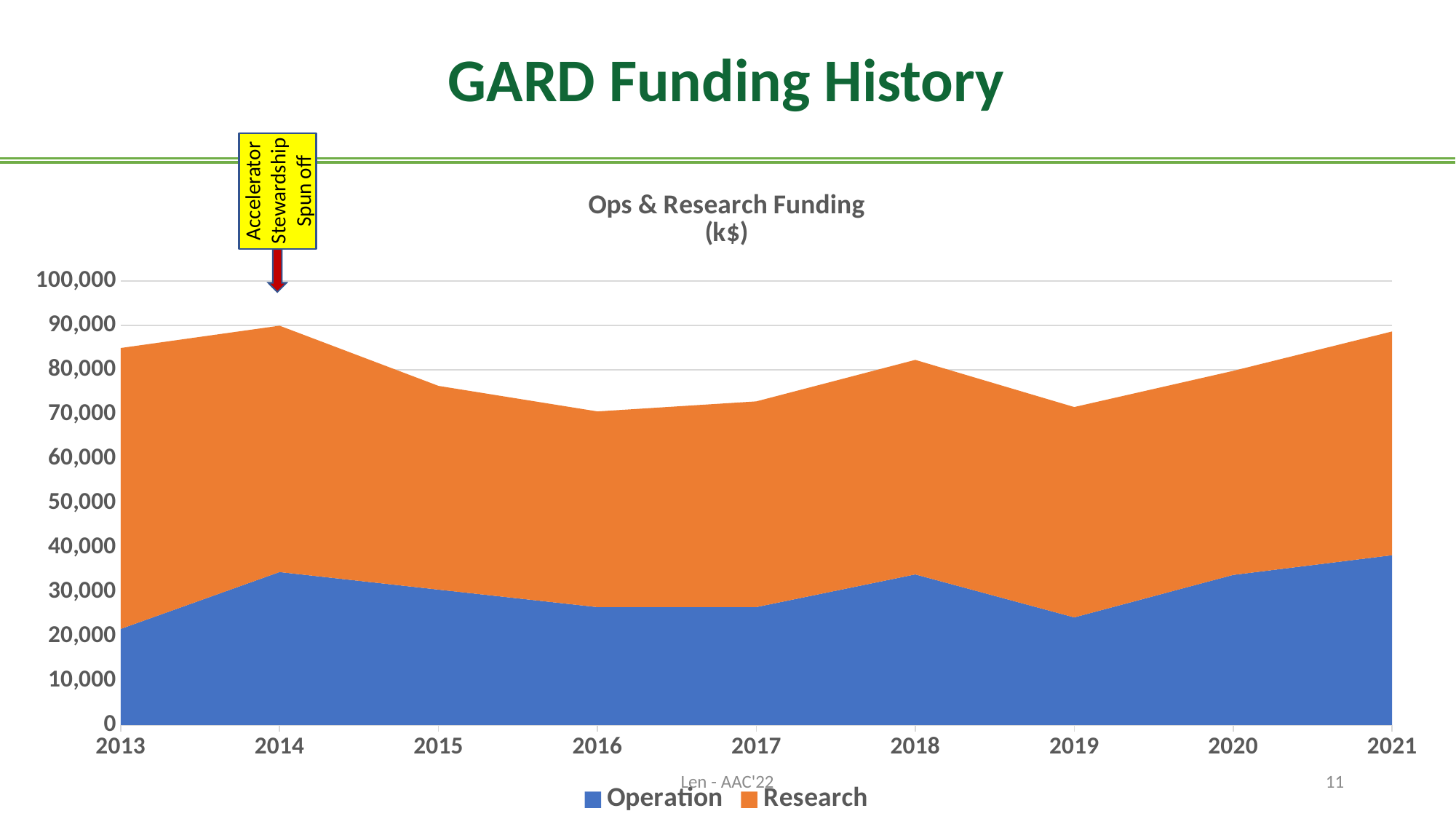
Is the Operation value for 2021 greater or less than 40,000? less Is the Operation value for 2014 greater or less than 30,000? greater Which series is shown in orange in the chart? Research What is the title of the chart? Ops & Research Funding (k$) How many years are plotted along the x axis of the chart? 9 Is the Operation value for 2019 greater or less than 30,000? less In which year is the Operation value highest? 2021 Which year has the larger Operation value, 2014 or 2016? 2014 What kind of chart is shown on the slide? Stacked area chart How many series does the chart legend list? 2 Does the Operation value rise or fall from 2019 to 2021? rise